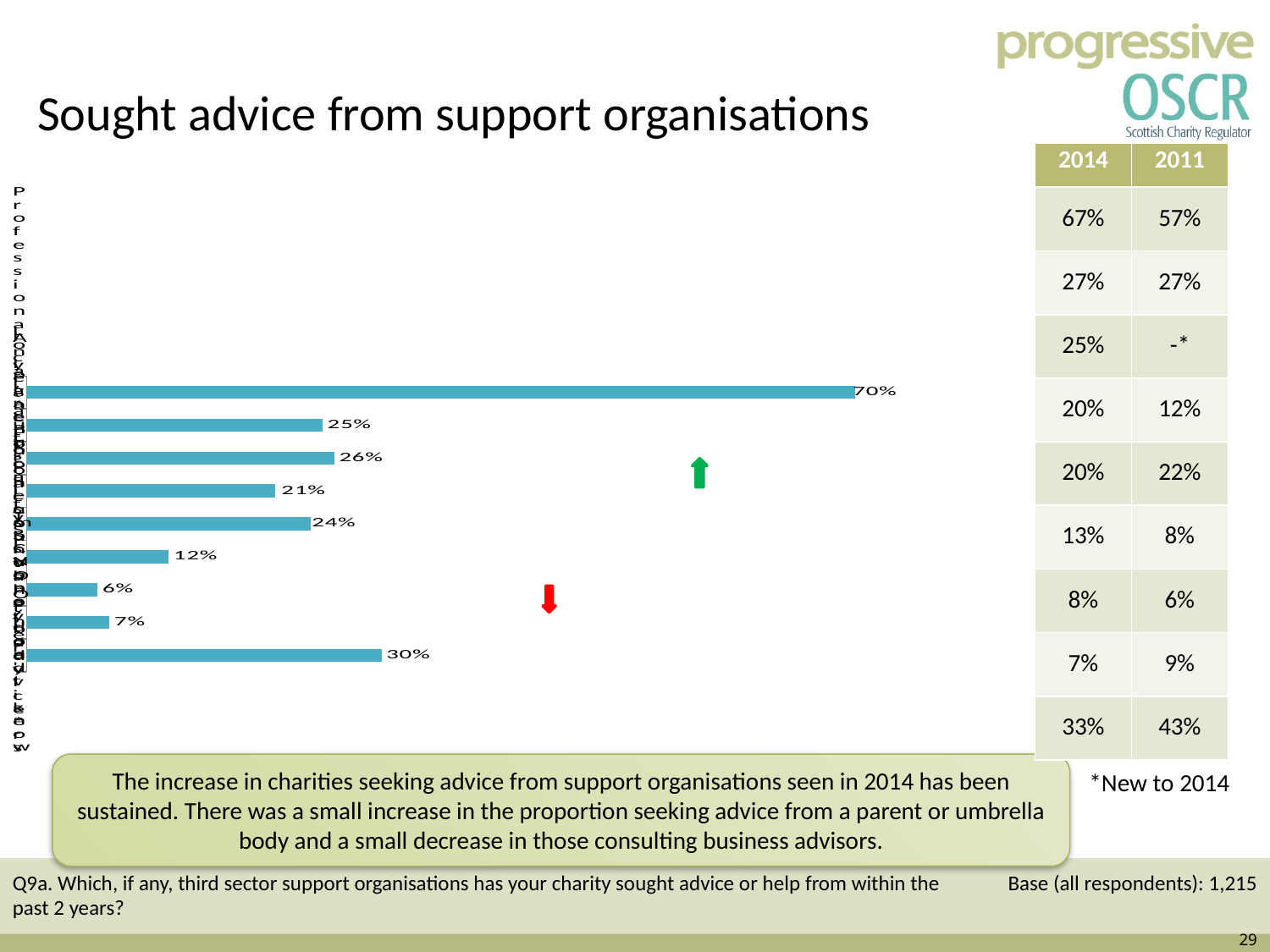
How many bars are plotted in the chart? 9 What is the difference between the top bar's value (70%) and the bottom bar's value (30%)? 40% What colour are the bars in the chart? blue What is the difference between the bar labelled 12% and the bar labelled 6%? 6% What is the value shown on the second bar from the top? 25% What is the value shown on the bottom bar of the chart? 30% Which is larger: the value on the second bar from the top (25%) or the value on the third bar from the top (26%)? 26% What is the value shown on the top bar of the chart? 70% What is the value shown on the third bar from the top? 26% What is the lowest value labelled on any bar in the chart? 6% What is the highest value labelled on any bar in the chart? 70% What kind of chart is shown on the slide? bar chart